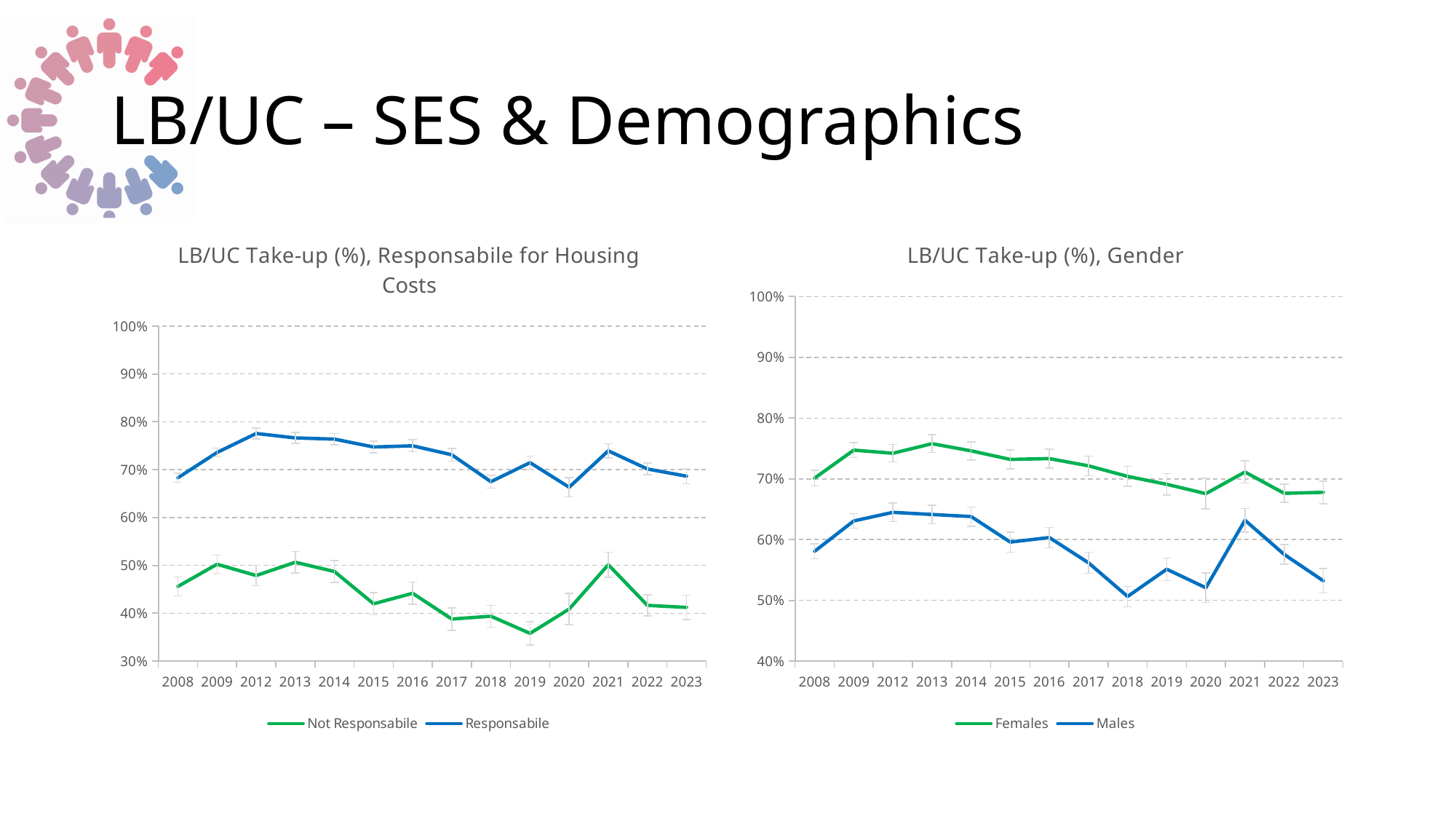
In the 'LB/UC Take-up (%), Gender' chart, is the value for Females in 2013 greater or less than 70%? greater In the 'LB/UC Take-up (%), Responsabile for Housing Costs' chart, is the value for Responsabile in 2012 greater or less than 70%? greater What type of chart is the 'LB/UC Take-up (%), Responsabile for Housing Costs' chart? Line chart In the 'LB/UC Take-up (%), Responsabile for Housing Costs' chart, in which year is the Not Responsabile series lowest? 2019 In the 'LB/UC Take-up (%), Gender' chart, in which year is the Males series lowest? 2018 In the 'LB/UC Take-up (%), Gender' chart, is the value for Males in 2008 greater or less than 60%? less In the 'LB/UC Take-up (%), Responsabile for Housing Costs' chart, which series has the higher value in 2008, Responsabile or Not Responsabile? Responsabile How many years are plotted along the x axis of the 'LB/UC Take-up (%), Responsabile for Housing Costs' chart? 14 How many series does the legend of the 'LB/UC Take-up (%), Gender' chart list? 2 Which series is drawn in green in the 'LB/UC Take-up (%), Gender' chart? Females In the 'LB/UC Take-up (%), Gender' chart, does the Males series rise or fall from 2013 to 2018? Fall